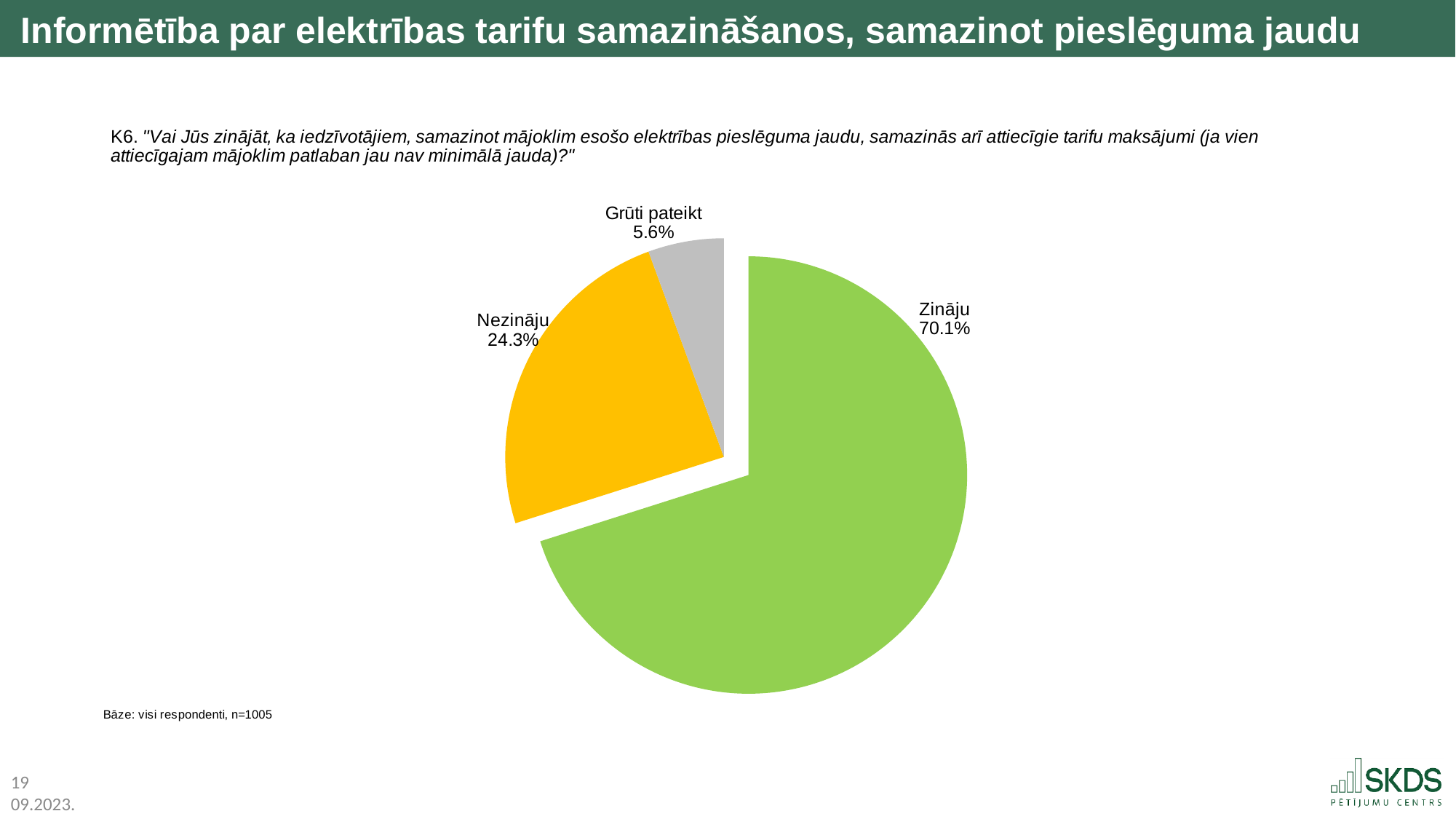
What is the difference in percentage points between "Nezināju" and "Grūti pateikt"? 18.7 Which is larger, the share for "Nezināju" or the share for "Grūti pateikt"? Nezināju How many slices does the pie chart have? 3 What percentage of respondents answered "Nezināju"? 24.3% What colour is the "Zināju" slice? green What is the difference in percentage points between "Zināju" and "Nezināju"? 45.8 What is the base (number of respondents) stated below the chart? n=1005 Which response has the smallest share of the pie? Grūti pateikt What type of chart is shown on the slide? pie chart Which response has the largest share of the pie? Zināju What percentage of respondents answered "Grūti pateikt"? 5.6% What percentage of respondents answered "Zināju"? 70.1%